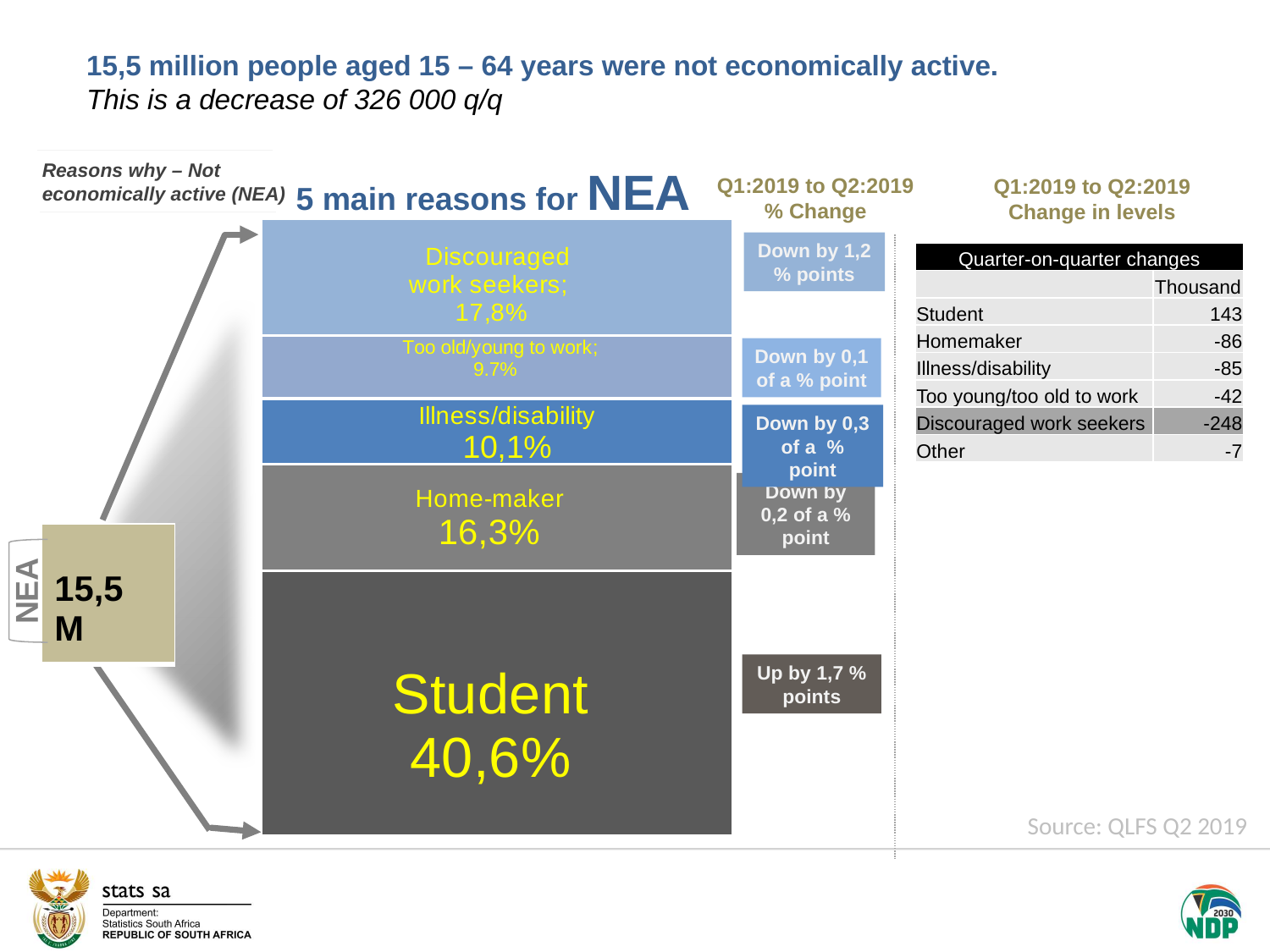
In the '5 main reasons for NEA' chart, what share is shown for Home-maker? 16,3% How many reasons (segments) are shown in the '5 main reasons for NEA' chart? 5 In the '5 main reasons for NEA' chart, which is larger: the share for Discouraged work seekers or the share for Home-maker? Discouraged work seekers In the '5 main reasons for NEA' chart, what is the difference between the Student share and the Home-maker share? 24,3 percentage points In the '5 main reasons for NEA' chart, what share is shown for Student? 40,6% According to the '% Change' annotations next to the chart, what is the Q1:2019 to Q2:2019 change for Student? Up by 1,7 % points In the '5 main reasons for NEA' chart, what share is shown for Illness/disability? 10,1% In the '5 main reasons for NEA' chart, which reason has the smallest share? Too old/young to work In the '5 main reasons for NEA' chart, what share is shown for Discouraged work seekers? 17,8% In the '5 main reasons for NEA' chart, what share is shown for Too old/young to work? 9.7% In the '5 main reasons for NEA' chart, which reason has the largest share? Student What kind of chart is used to show the 5 main reasons for NEA? Stacked bar chart